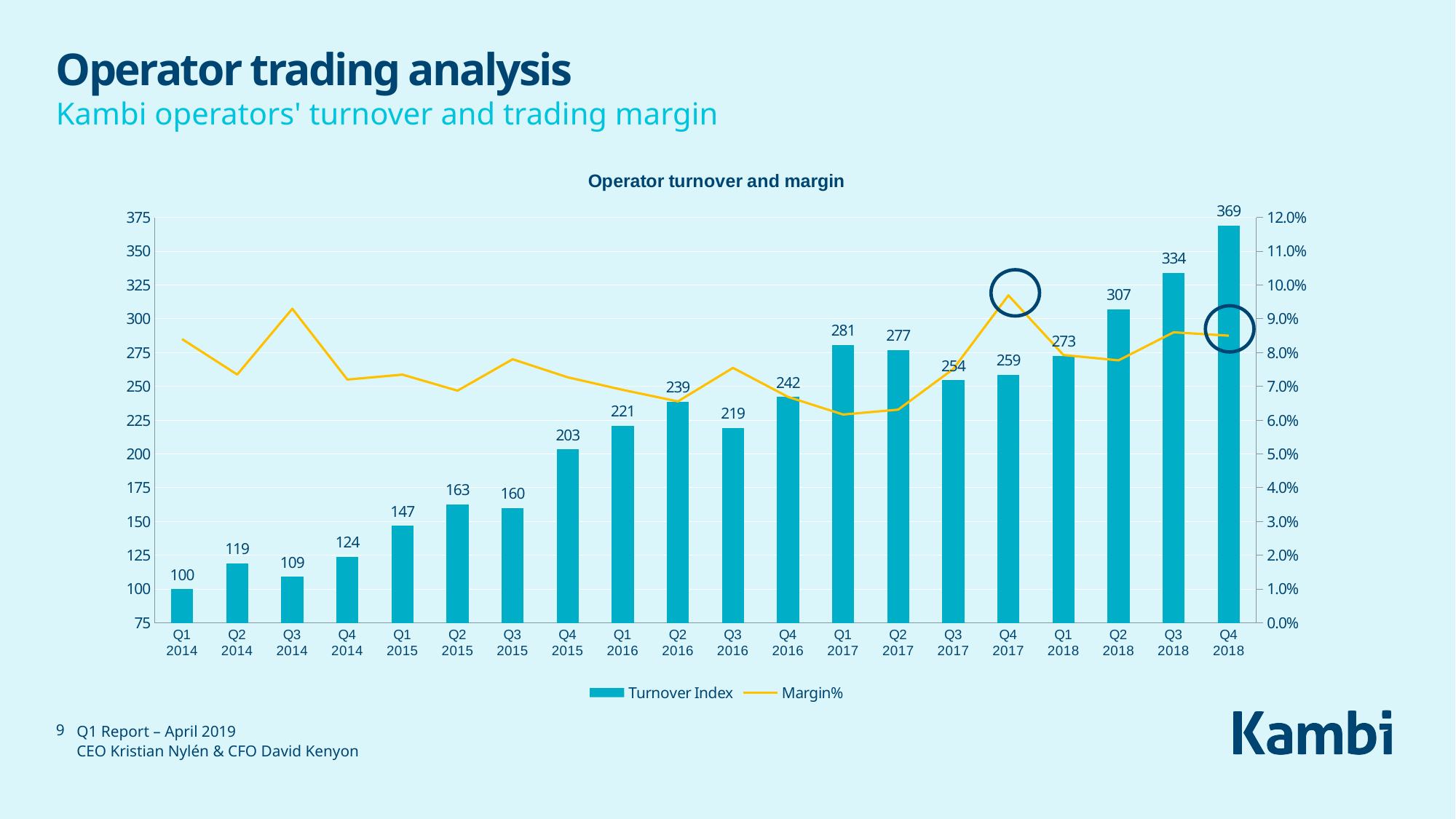
What is the Turnover Index value for Q3 2015? 160 What is the Turnover Index value for Q1 2017? 281 Which quarter has the highest Turnover Index? Q4 2018 Which quarter has the lowest Turnover Index? Q1 2014 How many series does the legend list? 2 How many quarters are shown on the x axis of the chart? 20 Is the Margin% value for Q4 2017 greater or less than 9.0%? greater What is the Turnover Index value for Q4 2018? 369 Is the Margin% value for Q1 2017 greater or less than 7.0%? less What is the title of the chart? Operator turnover and margin Which quarter has a higher Turnover Index, Q3 2016 or Q2 2016? Q2 2016 What is the difference in Turnover Index between Q4 2018 and Q3 2018? 35